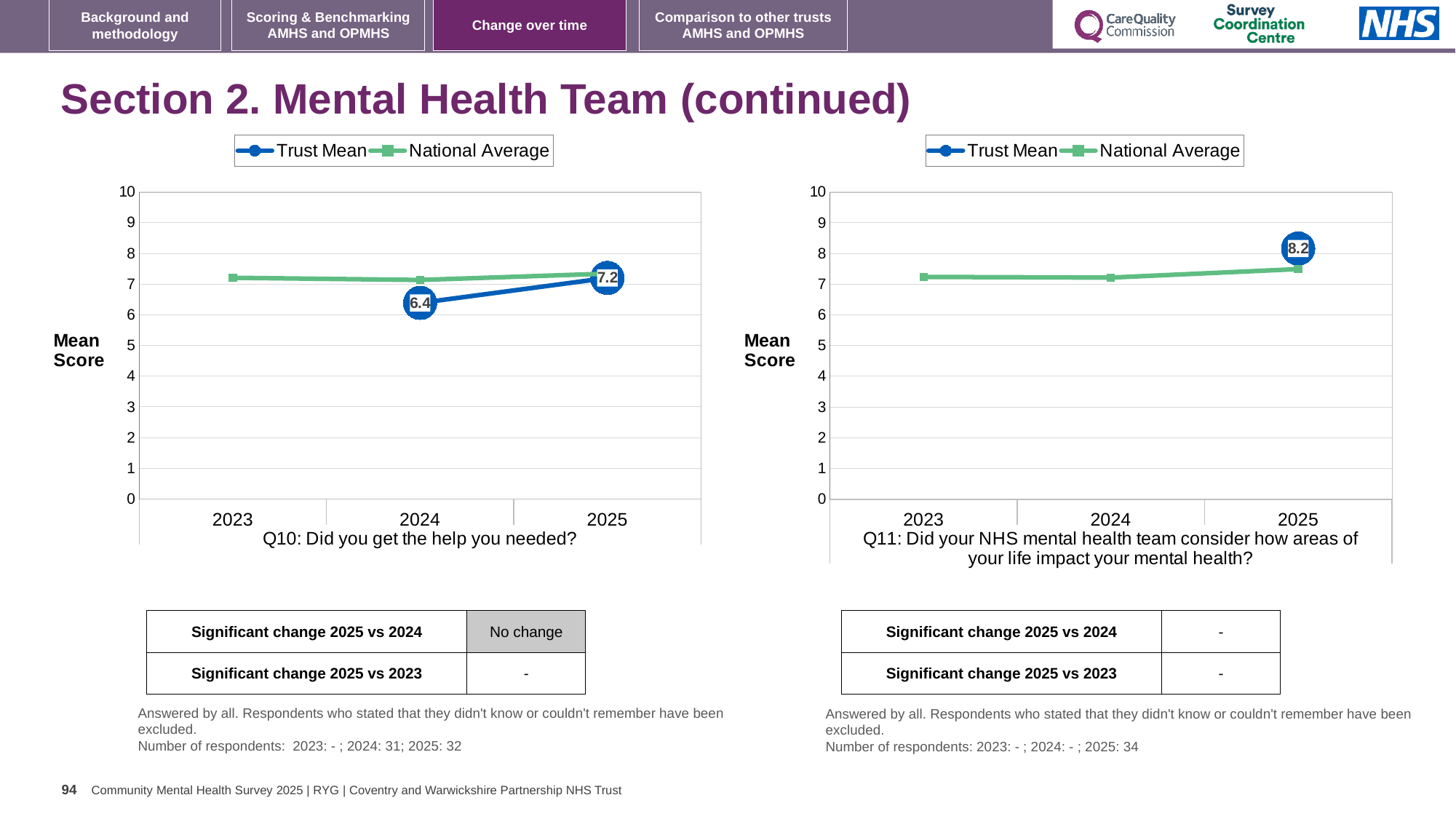
In the Q11 chart (right), which series has the higher value in 2025, Trust Mean or National Average? Trust Mean In the Q11 chart (right), is the National Average value for 2023 greater or less than 5? greater In the Q10 chart (left), does the Trust Mean rise or fall from 2024 to 2025? rise In the Q10 chart (left), what is the Trust Mean score for 2024? 6.4 In the Q11 chart (right), what is the Trust Mean score for 2025? 8.2 How many years are shown on the x axis of the Q11 chart (right)? 3 How many series does the legend of the Q10 chart (left) list? 2 What are the two series named in the legend of the Q10 chart (left)? Trust Mean and National Average What type of chart is used for Q11 (right)? line chart In the Q10 chart (left), by how much did the Trust Mean increase from 2024 to 2025? 0.8 In the Q10 chart (left), what is the Trust Mean score for 2025? 7.2 In the Q10 chart (left), is the Trust Mean higher in 2024 or 2025? 2025